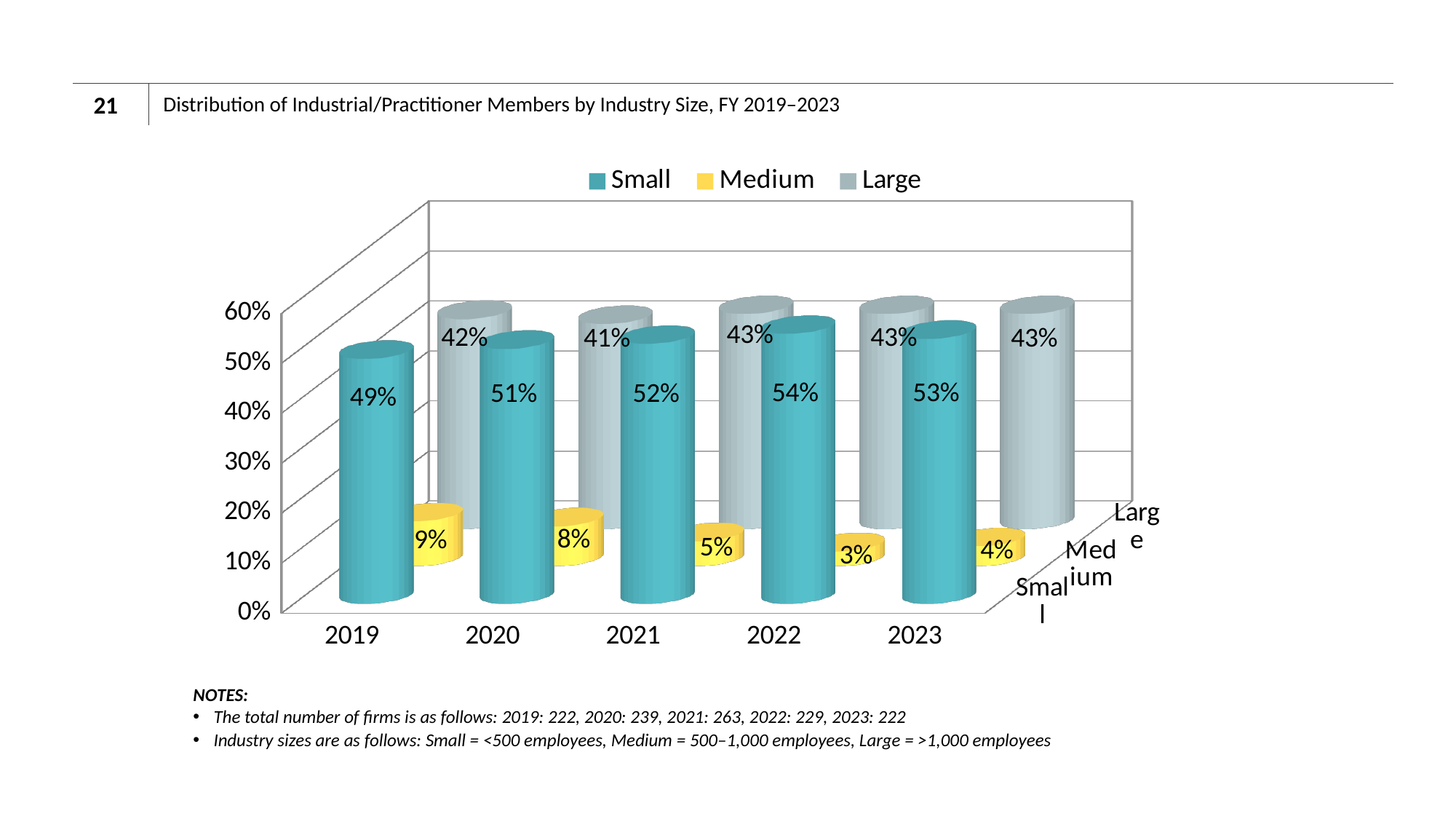
What is the value for Small in 2019? 49% What is the difference between the Small and Large values in 2023? 10% In which year is the Medium series lowest? 2022 How many years are shown on the x axis? 5 What is the value for Medium in 2021? 5% Does the Medium series generally rise or fall from 2019 to 2023? Fall How many series does the legend list? 3 Which is larger in 2019, the Small value or the Large value? Small In which year is the Small series highest? 2022 What is the value for Small in 2022? 54% What kind of chart is shown on the slide? Bar chart What is the value for Large in 2020? 41%